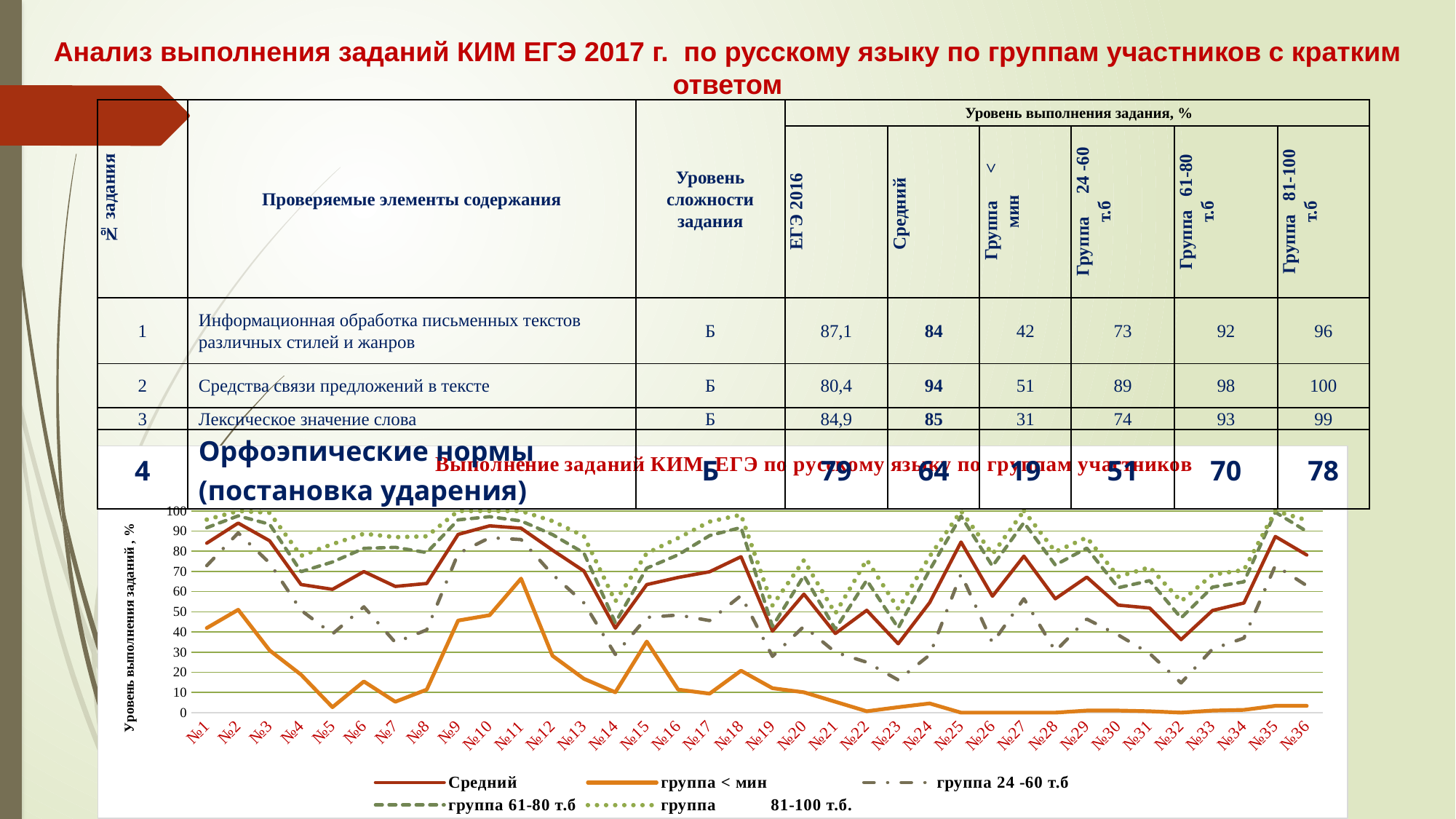
Is the value of the 'Средний' series at №2 greater or less than 90? greater Which series has the lowest values across the chart? группа < мин What is the title of the chart? Выполнение заданий КИМ ЕГЭ по русскому языку по группам участников Is the value of the 'Средний' series at №23 greater or less than 40? less How many task categories (№) are plotted along the x axis of the chart? 36 What is the label of the chart's vertical axis? Уровень выполнения заданий, % Is the value of the 'группа < мин' series at №11 greater or less than 50? greater At №11, which is larger: the 'Средний' series or the 'группа < мин' series? Средний What kind of chart is shown on the slide? line chart Does the 'группа < мин' series rise or fall from №11 to №14? fall How many series does the chart legend list? 5